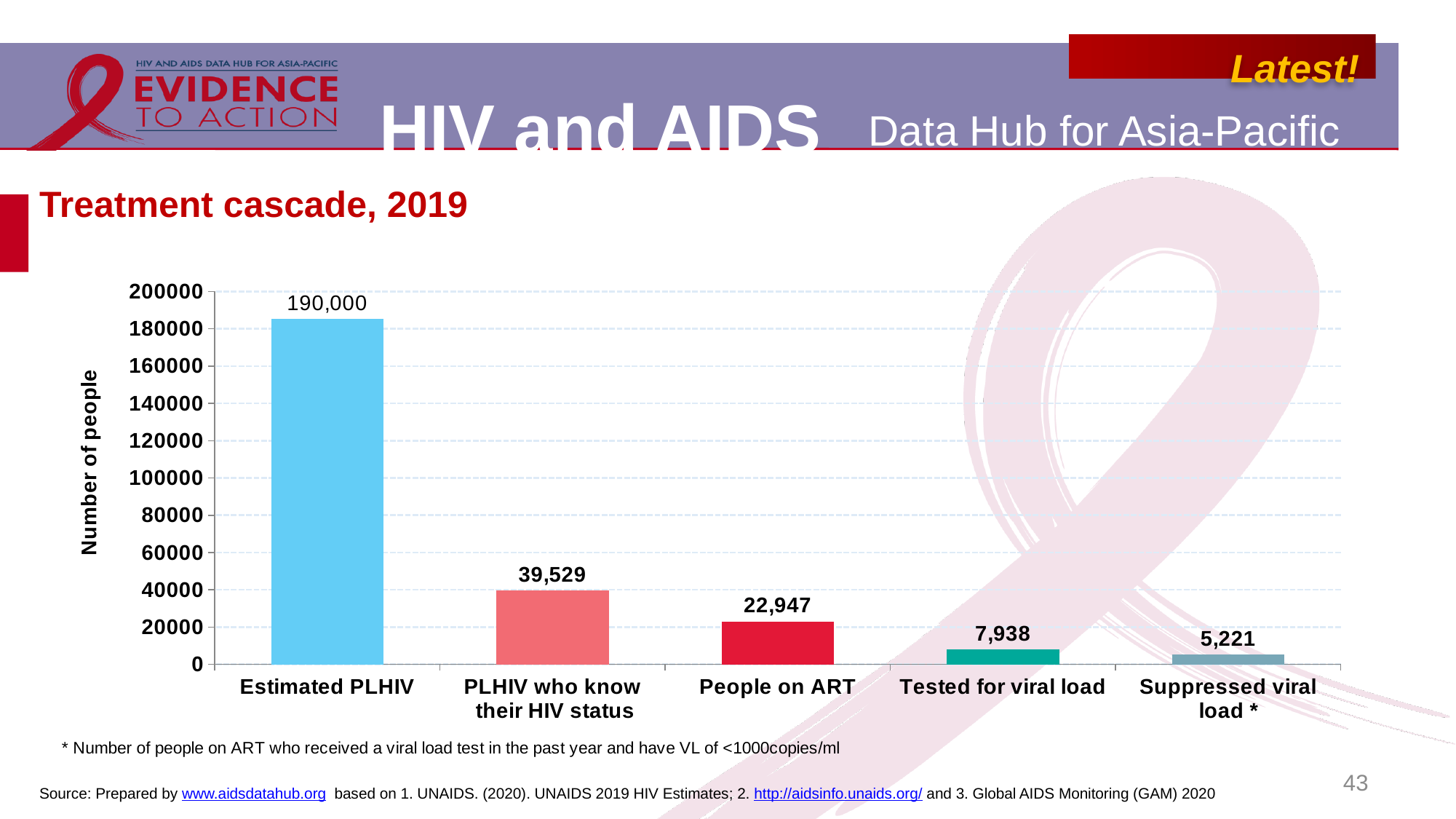
Do the values rise or fall from left to right along the x axis? Fall Which category has the highest value? Estimated PLHIV What is the difference between PLHIV who know their HIV status and People on ART? 16,582 What is the value for People on ART? 22,947 What kind of chart is shown on the slide? Bar chart What is the value for Estimated PLHIV? 190,000 What is the value for Tested for viral load? 7,938 How many categories are shown on the chart? 5 What is the value for Suppressed viral load? 5,221 Which category has the lowest value? Suppressed viral load What is the value for PLHIV who know their HIV status? 39,529 Which is larger, Tested for viral load or Suppressed viral load? Tested for viral load